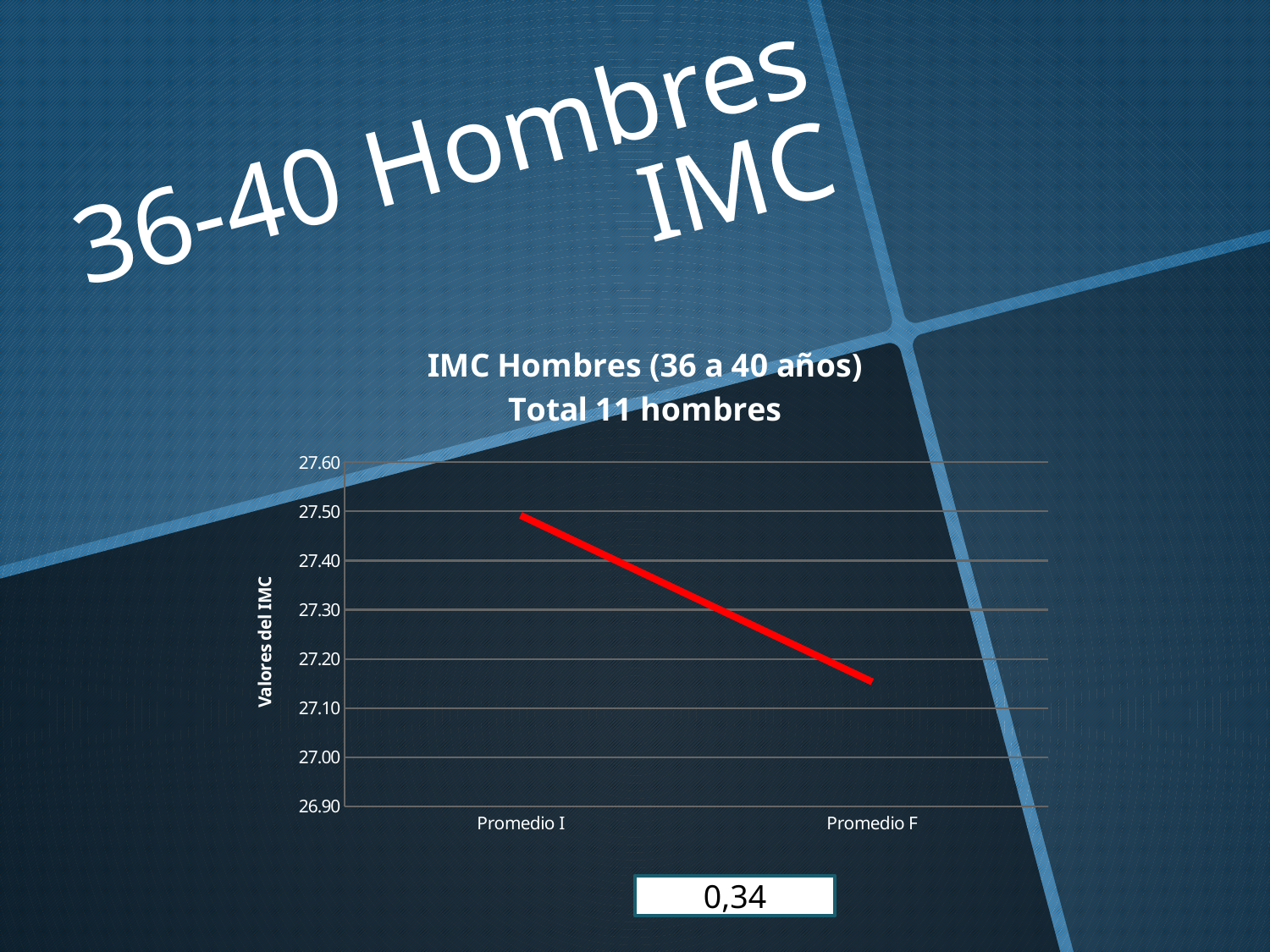
What are the two categories on the x axis of the chart? Promedio I and Promedio F How many categories are shown on the x axis of the chart? 2 Is the value for Promedio F greater or less than 27.20? less What kind of chart is shown on the slide? line chart Which is larger, the value for Promedio I or the value for Promedio F? Promedio I Which category has the highest value in the chart? Promedio I Is the value for Promedio F greater or less than 27.00? greater What is the label of the vertical axis of the chart? Valores del IMC What is the title of the chart? IMC Hombres (36 a 40 años) Total 11 hombres Is the value for Promedio I greater or less than 27.40? greater Which category has the lowest value in the chart? Promedio F Does the line rise or fall from Promedio I to Promedio F? fall